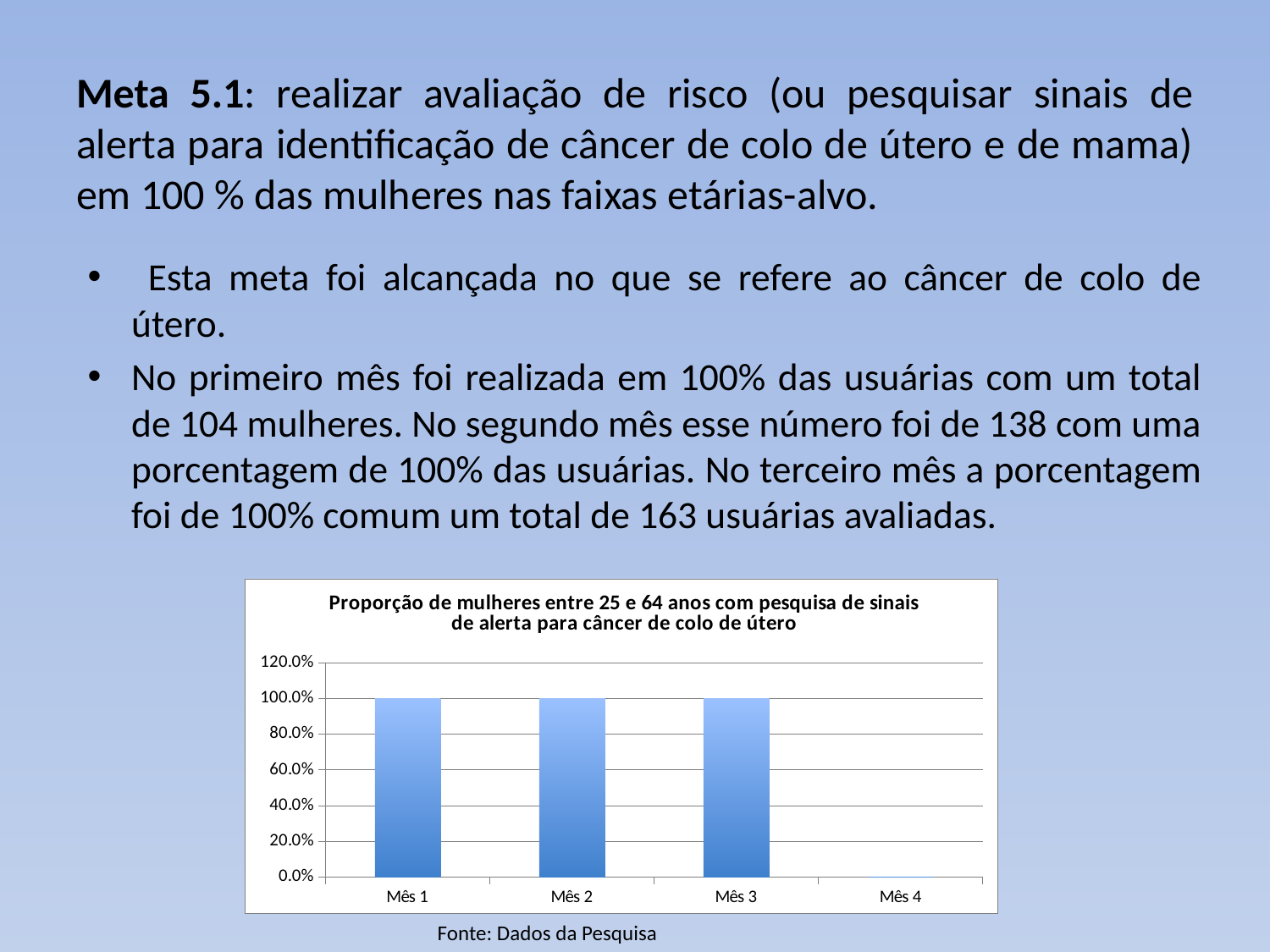
What is the highest value shown on the y axis of the chart? 120.0% Do the values rise or fall from Mês 3 to Mês 4? fall What is the value for Mês 2 in the chart? 100.0% What is the value for Mês 3 in the chart? 100.0% Which category has the lowest value in the chart? Mês 4 What is the title of the chart? Proporção de mulheres entre 25 e 64 anos com pesquisa de sinais de alerta para câncer de colo de útero What is the value for Mês 1 in the chart? 100.0% How many categories are shown on the x axis of the chart? 4 Is the value for Mês 2 greater or less than 80.0%? greater Is the value for Mês 4 greater or less than 20.0%? less Which is larger, the value for Mês 3 or the value for Mês 4? Mês 3 What kind of chart is shown on the slide? bar chart